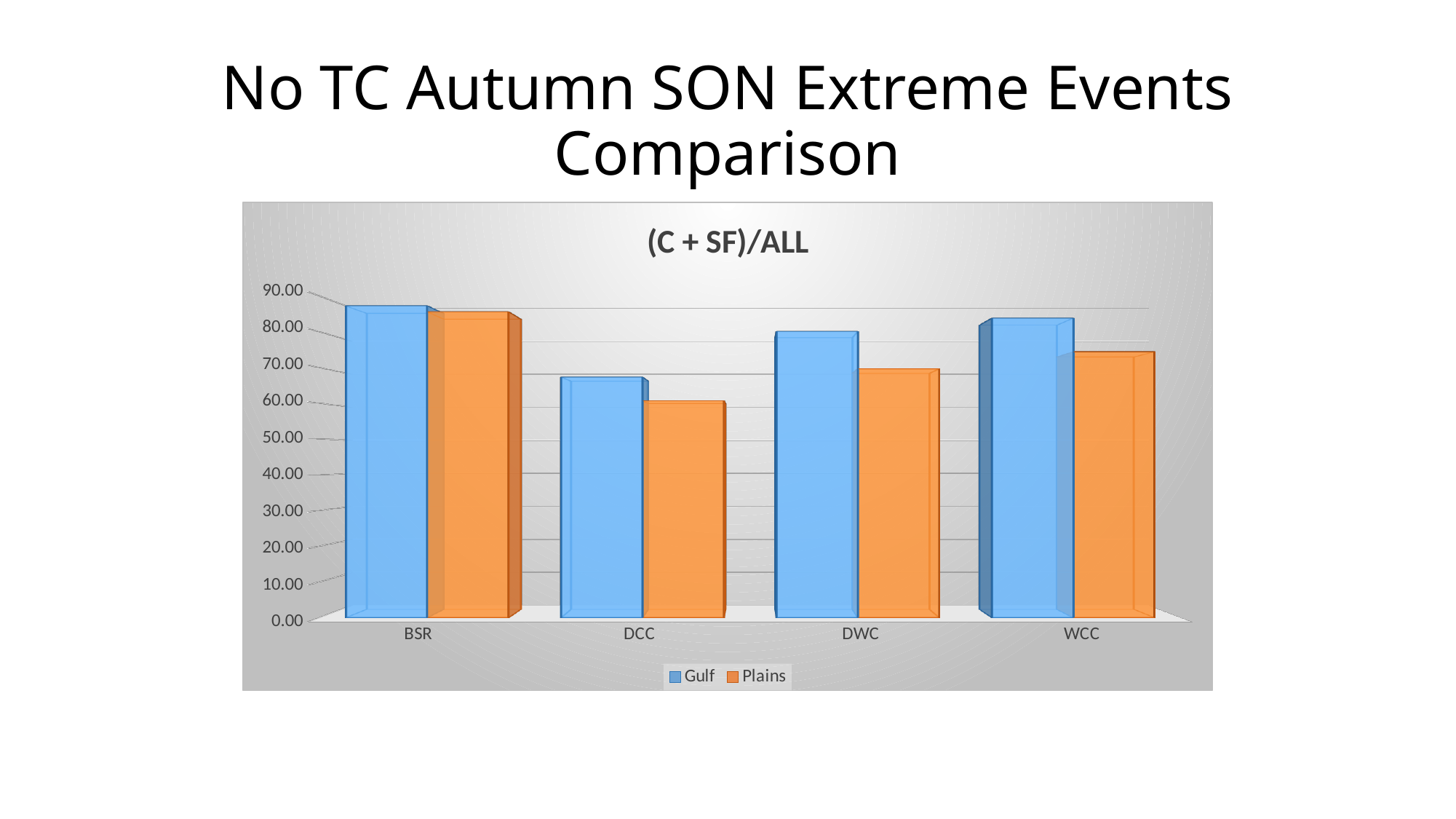
Which category has the lowest Plains value? DCC Is the Gulf value for BSR greater or less than 80.00? greater What kind of chart is shown on the slide? bar chart How many series does the chart legend list? 2 Which series is shown in orange in the chart? Plains Which category has the highest Plains value? BSR How many categories are shown on the x axis of the chart? 4 What is the title of the chart? (C + SF)/ALL Which category has the lowest Gulf value? DCC For DWC, which is larger, the Gulf value or the Plains value? Gulf Which category has the highest Gulf value? BSR Is the Plains value for DCC greater or less than 70.00? less